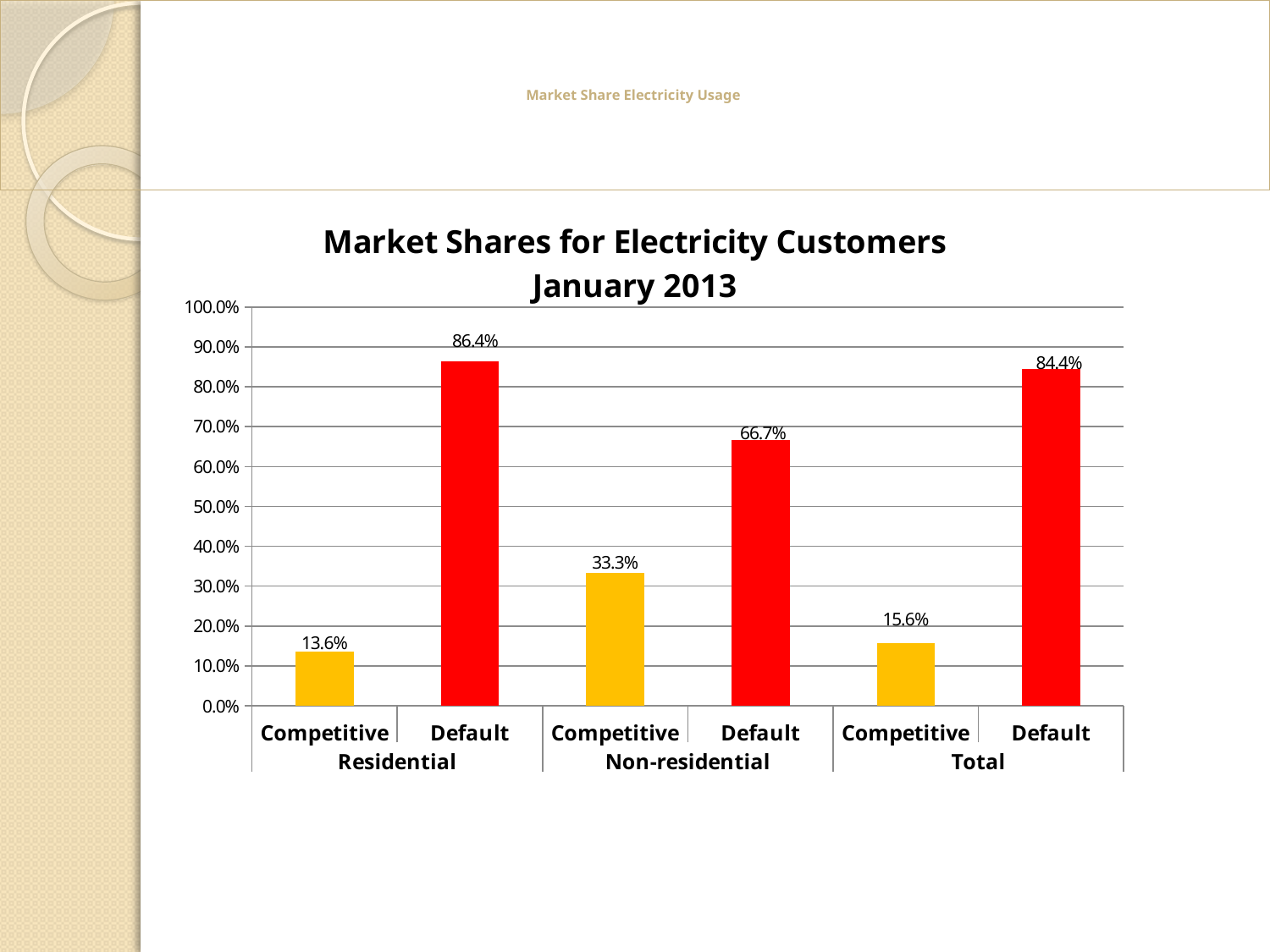
Which is larger: Competitive in the Non-residential group or Competitive in the Total group? Competitive in the Non-residential group What is the title of the chart? Market Shares for Electricity Customers January 2013 What is the value for Competitive in the Residential group? 13.6% How many bars are plotted in the chart? 6 What is the value for Default in the Non-residential group? 66.7% What kind of chart is shown on the slide? Bar chart What is the value for Default in the Total group? 84.4% What is the value for Competitive in the Total group? 15.6% Which bar has the highest value? Residential Default Which bar has the lowest value? Residential Competitive What is the difference between Default and Competitive in the Non-residential group? 33.4% Is the value for Default in the Non-residential group greater or less than 70.0%? less